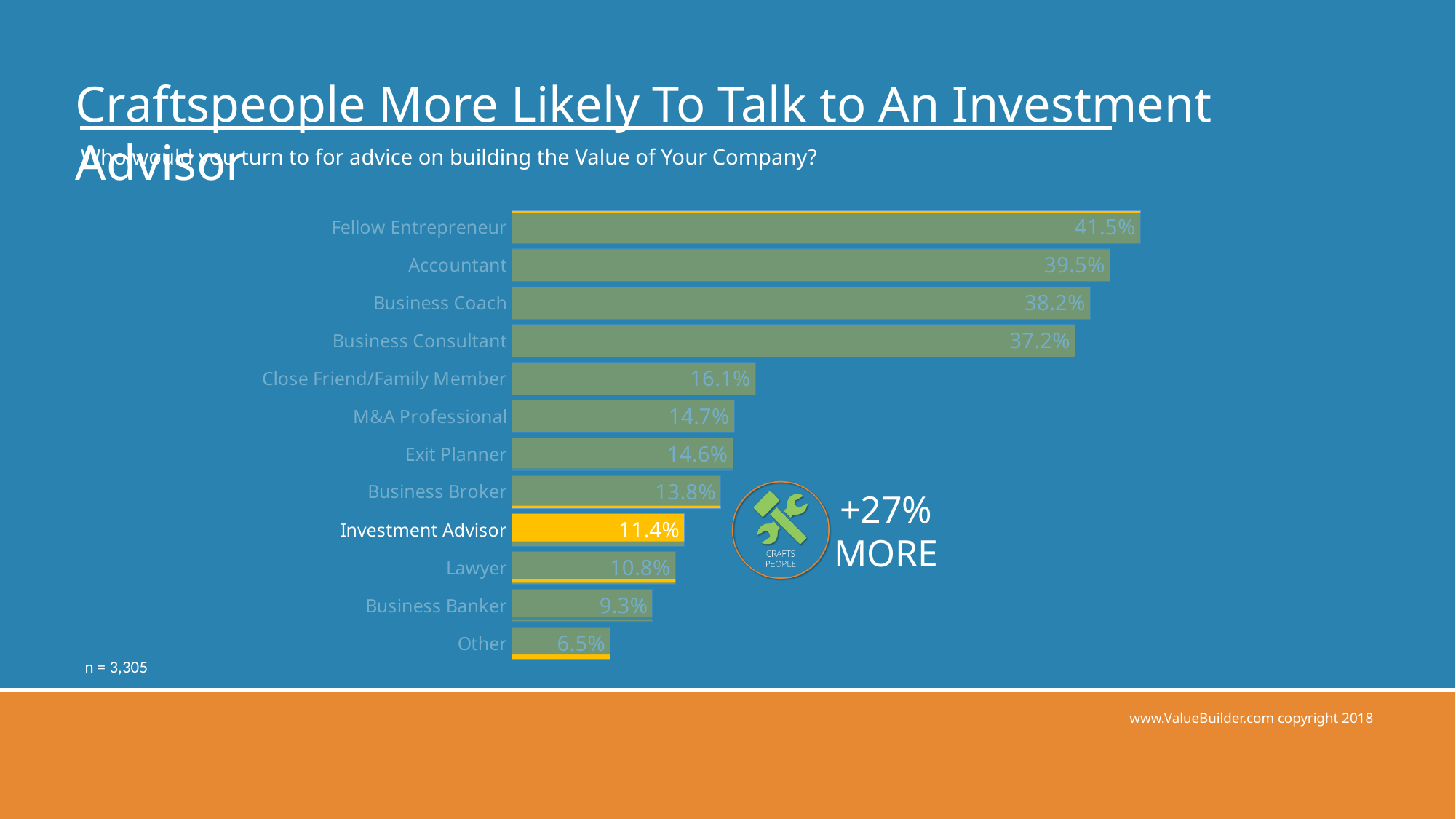
What is the difference between the values for Investment Advisor and Lawyer? 0.6% Which category has the lowest value in the chart? Other How many categories are shown in the chart? 12 What percentage of respondents would turn to a Fellow Entrepreneur for advice on building the value of their company? 41.5% What is the value shown for Investment Advisor? 11.4% Which bar in the chart is highlighted in a different colour (yellow) from the others? Investment Advisor What is the difference between the values for Fellow Entrepreneur and Accountant? 2.0% Which is larger, the value for Business Banker or the value for Lawyer? Lawyer Which is larger, the value for Business Coach or the value for Business Consultant? Business Coach What is the value shown for Close Friend/Family Member? 16.1% What kind of chart is shown on the slide? Bar chart Which category has the highest value in the chart? Fellow Entrepreneur